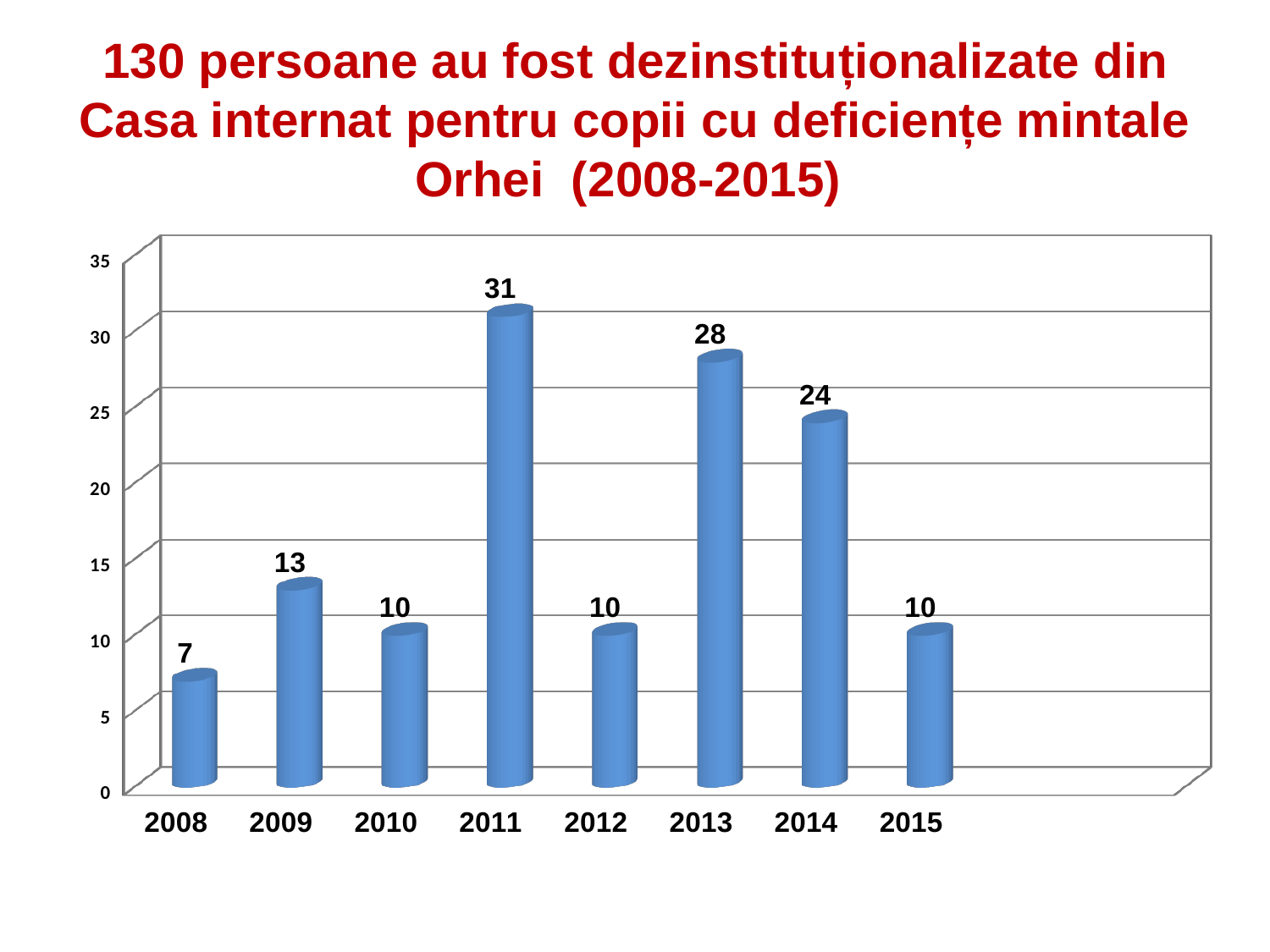
How many years are shown on the x axis? 8 Which year has the lowest value? 2008 What is the value for 2008? 7 Which year has the highest value? 2011 What is the value for 2014? 24 How many years have a value of 10? 3 What kind of chart is shown on the slide? bar chart What is the difference between the values for 2009 and 2008? 6 Which is larger, the value for 2013 or the value for 2014? 2013 What is the difference between the values for 2011 and 2013? 3 What is the value for 2011? 31 Do the values rise or fall from 2011 to 2012? fall